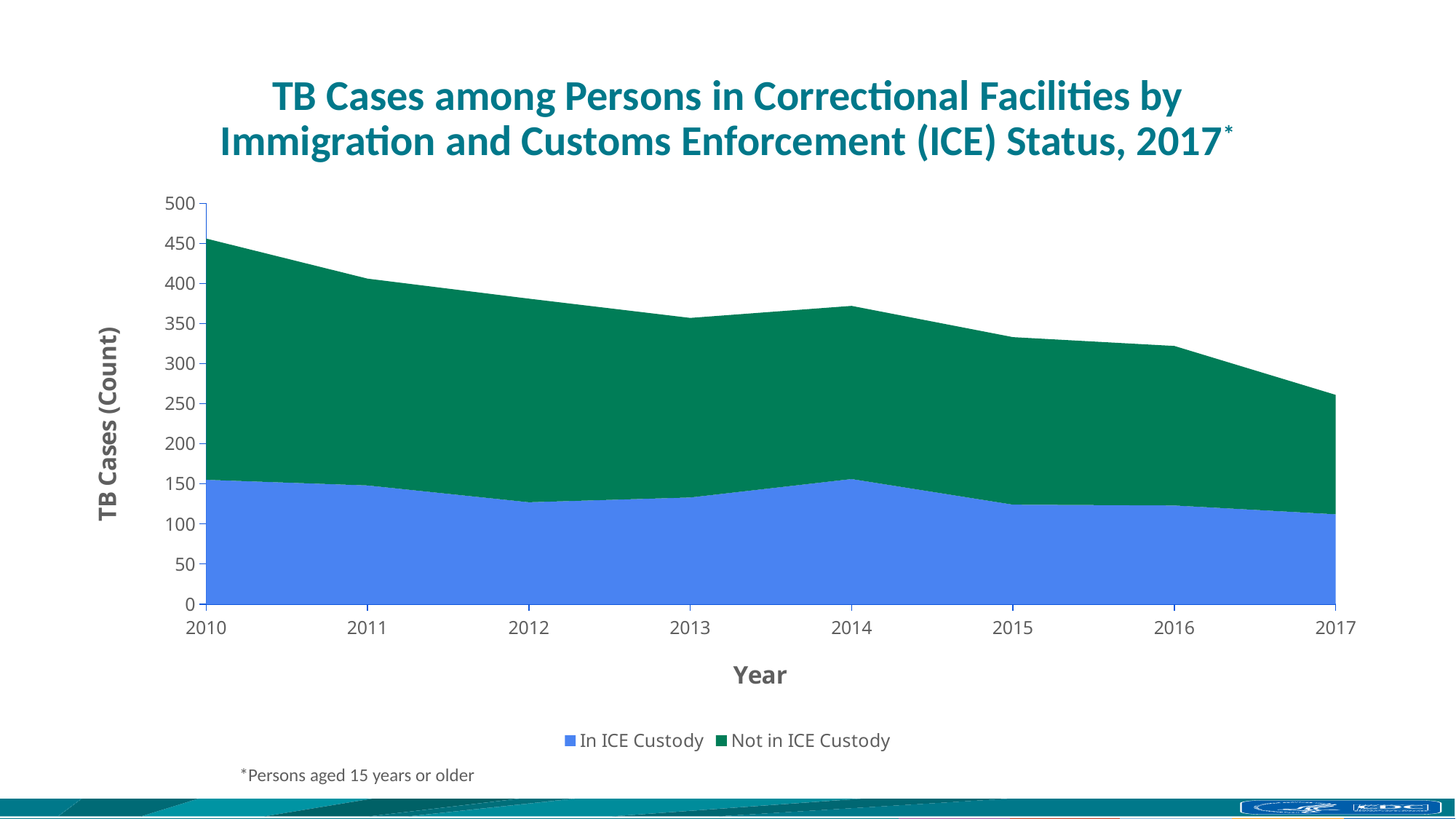
How many series does the legend list? 2 Is the total number of TB cases in 2010 greater or less than 400? greater What is the label of the y axis? TB Cases (Count) Which year has the highest total number of TB cases? 2010 Which year has the lowest total number of TB cases? 2017 Does the total number of TB cases generally rise or fall from 2010 to 2017? fall Is the value for In ICE Custody in 2017 greater or less than 150? less In 2017, which series is larger: In ICE Custody or Not in ICE Custody? Not in ICE Custody How many years are plotted along the x axis? 8 Is the total number of TB cases in 2016 greater or less than 350? less What kind of chart is shown on the slide? Stacked area chart